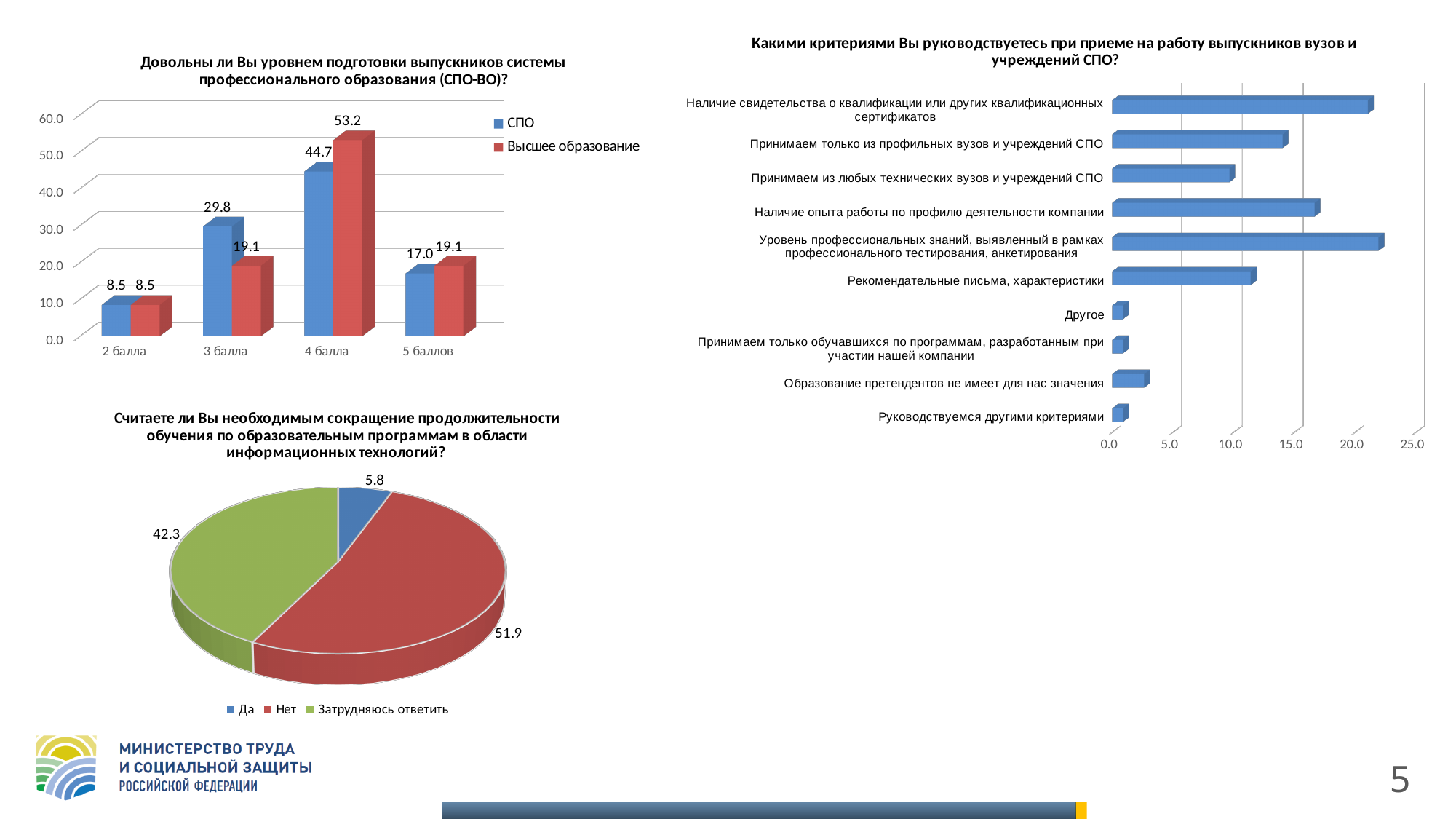
How many categories are shown in the chart 'Какими критериями Вы руководствуетесь при приеме на работу выпускников вузов и учреждений СПО?'? 10 In the chart 'Довольны ли Вы уровнем подготовки выпускников системы профессионального образования (СПО-ВО)?', what is the value for СПО at 3 балла? 29.8 In the chart 'Какими критериями Вы руководствуетесь при приеме на работу выпускников вузов и учреждений СПО?', is the value for 'Наличие опыта работы по профилю деятельности компании' greater or less than 15.0? greater What type of chart is 'Считаете ли Вы необходимым сокращение продолжительности обучения по образовательным программам в области информационных технологий?'? pie chart In the chart 'Довольны ли Вы уровнем подготовки выпускников системы профессионального образования (СПО-ВО)?', what is the value for Высшее образование at 4 балла? 53.2 In the chart 'Какими критериями Вы руководствуетесь при приеме на работу выпускников вузов и учреждений СПО?', is the value for 'Другое' greater or less than 5.0? less In the pie chart 'Считаете ли Вы необходимым сокращение продолжительности обучения по образовательным программам в области информационных технологий?', what is the value for Нет? 51.9 In the chart 'Довольны ли Вы уровнем подготовки выпускников системы профессионального образования (СПО-ВО)?', which is larger at 3 балла: СПО or Высшее образование? СПО In the chart 'Довольны ли Вы уровнем подготовки выпускников системы профессионального образования (СПО-ВО)?', what is the difference between the СПО and Высшее образование values at 4 балла? 8.5 In the pie chart 'Считаете ли Вы необходимым сокращение продолжительности обучения по образовательным программам в области информационных технологий?', which answer has the smallest share? Да In the chart 'Довольны ли Вы уровнем подготовки выпускников системы профессионального образования (СПО-ВО)?', how many series does the legend list? 2 In the chart 'Довольны ли Вы уровнем подготовки выпускников системы профессионального образования (СПО-ВО)?', which category has the highest value for СПО? 4 балла